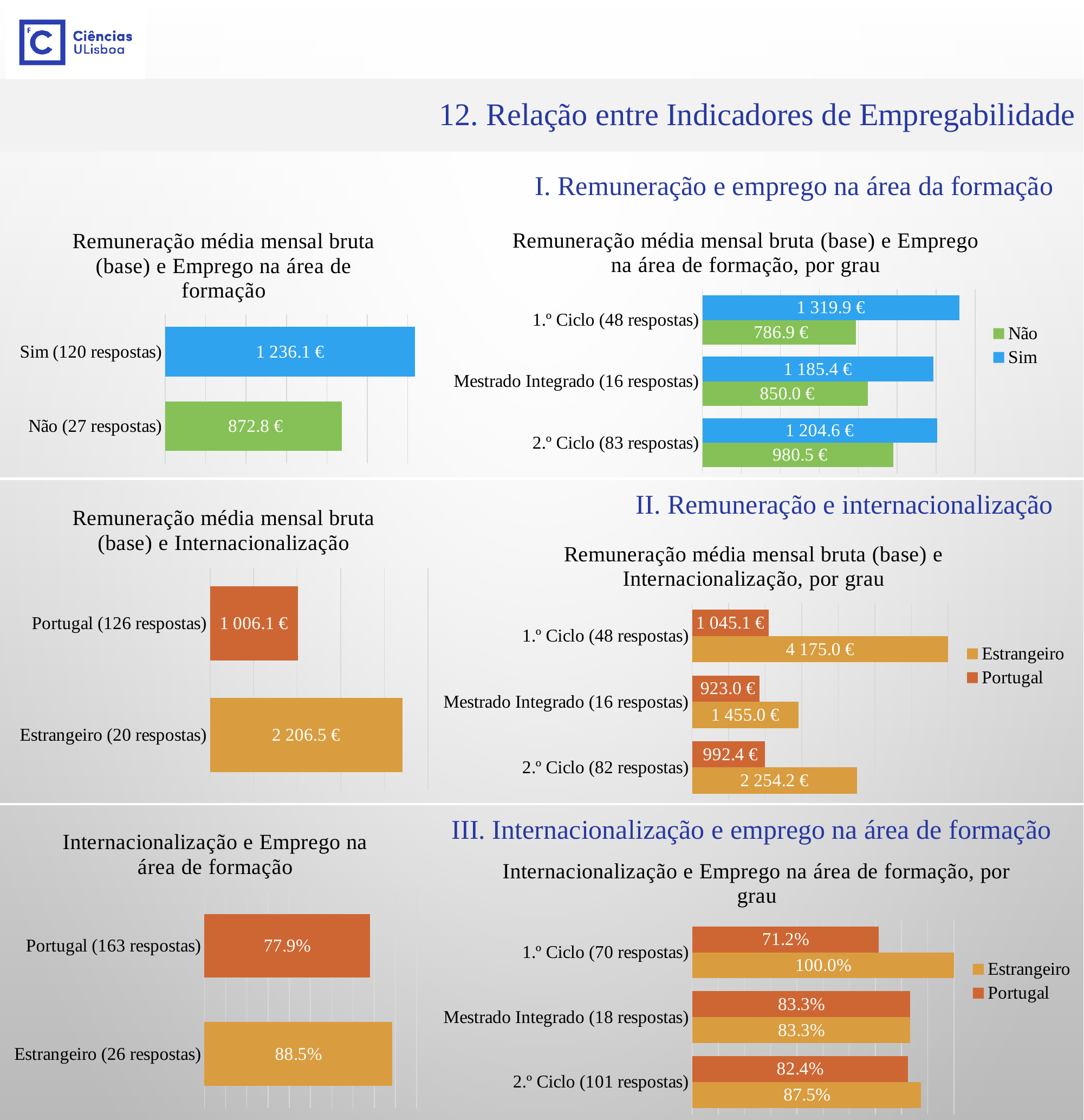
In the chart 'Internacionalização e Emprego na área de formação, por grau' (bottom right), what is the difference between the 'Estrangeiro' and 'Portugal' values for '2.º Ciclo (101 respostas)'? 5.1% In the chart 'Internacionalização e Emprego na área de formação' (bottom left), which is larger: the value for 'Portugal (163 respostas)' or 'Estrangeiro (26 respostas)'? Estrangeiro (26 respostas) In the chart 'Internacionalização e Emprego na área de formação, por grau' (bottom right), what is the 'Estrangeiro' value for '1.º Ciclo (70 respostas)'? 100.0% In the chart 'Remuneração média mensal bruta (base) e Emprego na área de formação, por grau' (top right), how many series does the legend list? 2 In the chart 'Remuneração média mensal bruta (base) e Internacionalização, por grau' (middle right), what is the 'Estrangeiro' value for '1.º Ciclo (48 respostas)'? 4 175.0 € In the chart 'Remuneração média mensal bruta (base) e Emprego na área de formação, por grau' (top right), what is the 'Não' value for '1.º Ciclo (48 respostas)'? 786.9 € In the chart 'Remuneração média mensal bruta (base) e Emprego na área de formação' (top left), what is the value for 'Sim (120 respostas)'? 1 236.1 € In the chart 'Remuneração média mensal bruta (base) e Internacionalização, por grau' (middle right), which degree has the lowest 'Portugal' value? Mestrado Integrado (16 respostas) In the chart 'Remuneração média mensal bruta (base) e Emprego na área de formação, por grau' (top right), which degree has the highest 'Sim' value? 1.º Ciclo (48 respostas) In the chart 'Remuneração média mensal bruta (base) e Emprego na área de formação' (top left), what is the difference between the 'Sim' and 'Não' values? 363.3 € In the chart 'Remuneração média mensal bruta (base) e Internacionalização' (middle left), what is the value for 'Estrangeiro (20 respostas)'? 2 206.5 € What kind of chart is 'Internacionalização e Emprego na área de formação' (bottom left)? Bar chart